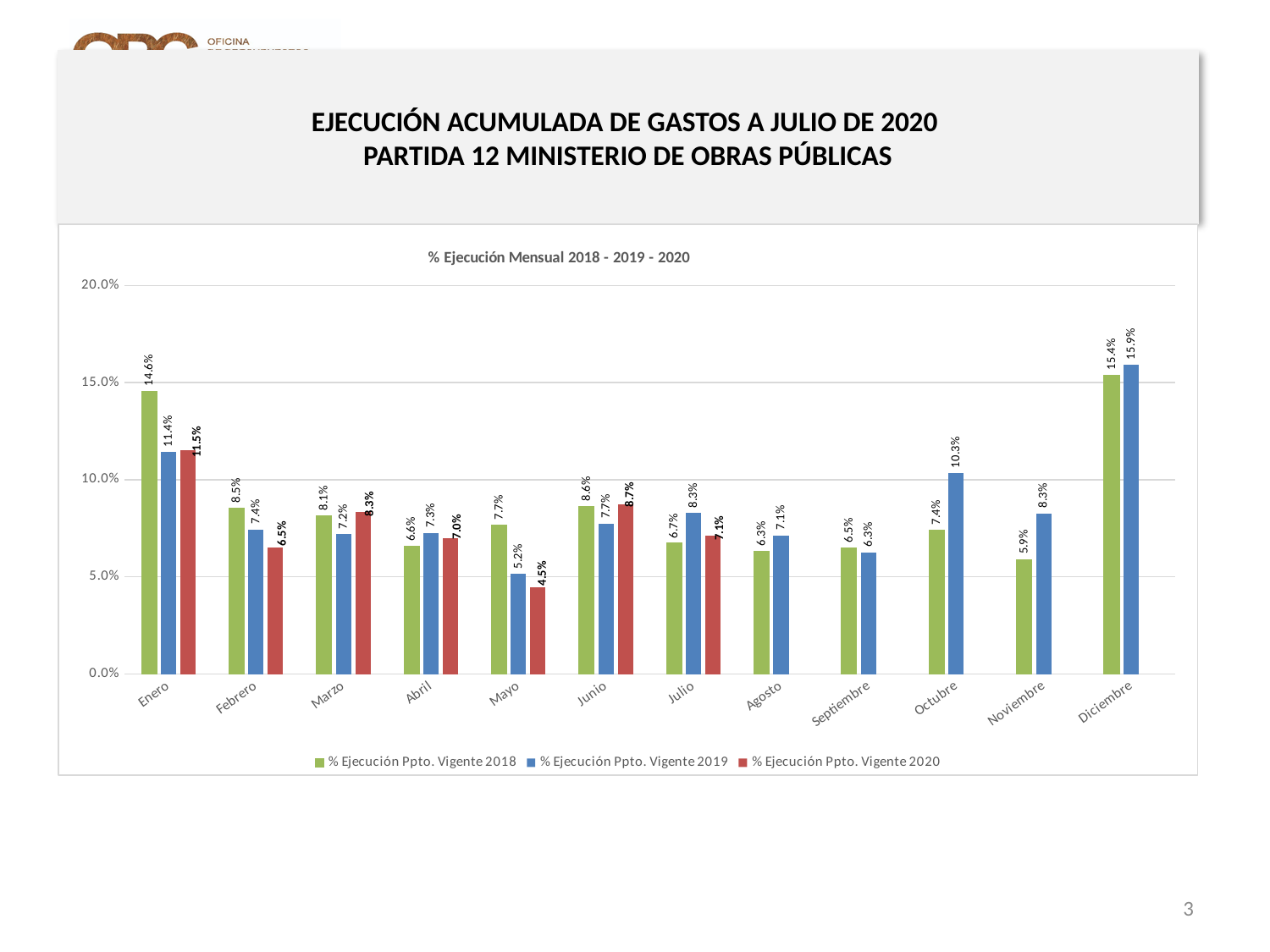
How many months are shown on the x axis? 12 Which month has the lowest value for % Ejecución Ppto. Vigente 2020? Mayo What kind of chart is shown? Bar chart What is the title of the chart? % Ejecución Mensual 2018 - 2019 - 2020 Is the value for % Ejecución Ppto. Vigente 2018 in Diciembre greater or less than 15.0%? greater In Julio, which series has the larger value: % Ejecución Ppto. Vigente 2019 or % Ejecución Ppto. Vigente 2020? % Ejecución Ppto. Vigente 2019 Which month has the highest value for % Ejecución Ppto. Vigente 2019? Diciembre How many series does the legend list? 3 What is the value for % Ejecución Ppto. Vigente 2020 in Mayo? 4.5% What is the difference between the 2018 and 2019 values in Enero? 3.2% What is the value for % Ejecución Ppto. Vigente 2018 in Enero? 14.6% What is the value for % Ejecución Ppto. Vigente 2019 in Octubre? 10.3%